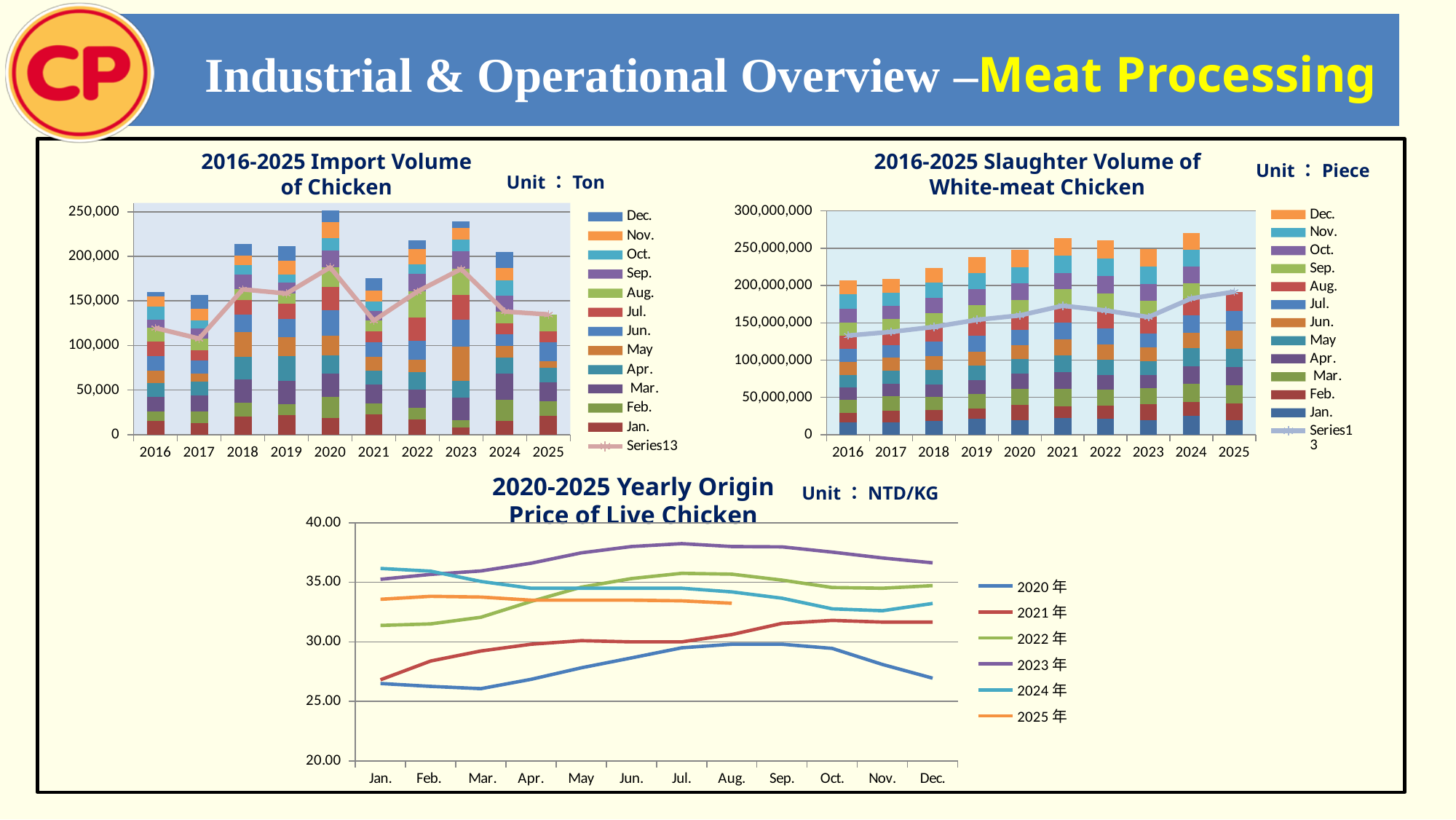
What kind of chart is the "2020-2025 Yearly Origin Price of Live Chicken" chart? line chart In the "2016-2025 Slaughter Volume of White-meat Chicken" chart, is the total bar for 2016 greater or less than 250,000,000? less How many series does the legend of the "2020-2025 Yearly Origin Price of Live Chicken" chart list? 6 In the "2016-2025 Import Volume of Chicken" chart, which year has the tallest bar? 2020 In the "2020-2025 Yearly Origin Price of Live Chicken" chart, is the 2023 value in Jul. greater or less than 35.00? greater In the "2016-2025 Import Volume of Chicken" chart, which year has the shortest bar? 2025 What kind of chart is the "2016-2025 Import Volume of Chicken" chart? combination stacked bar and line chart What unit is stated for the "2020-2025 Yearly Origin Price of Live Chicken" chart? NTD/KG In the "2020-2025 Yearly Origin Price of Live Chicken" chart, which line is higher in Jan., 2020 or 2024? 2024 In the "2016-2025 Import Volume of Chicken" chart, is the total bar for 2020 greater or less than 200,000? greater In the "2016-2025 Slaughter Volume of White-meat Chicken" chart, which year has the tallest bar? 2024 How many years are shown on the x axis of the "2016-2025 Slaughter Volume of White-meat Chicken" chart? 10